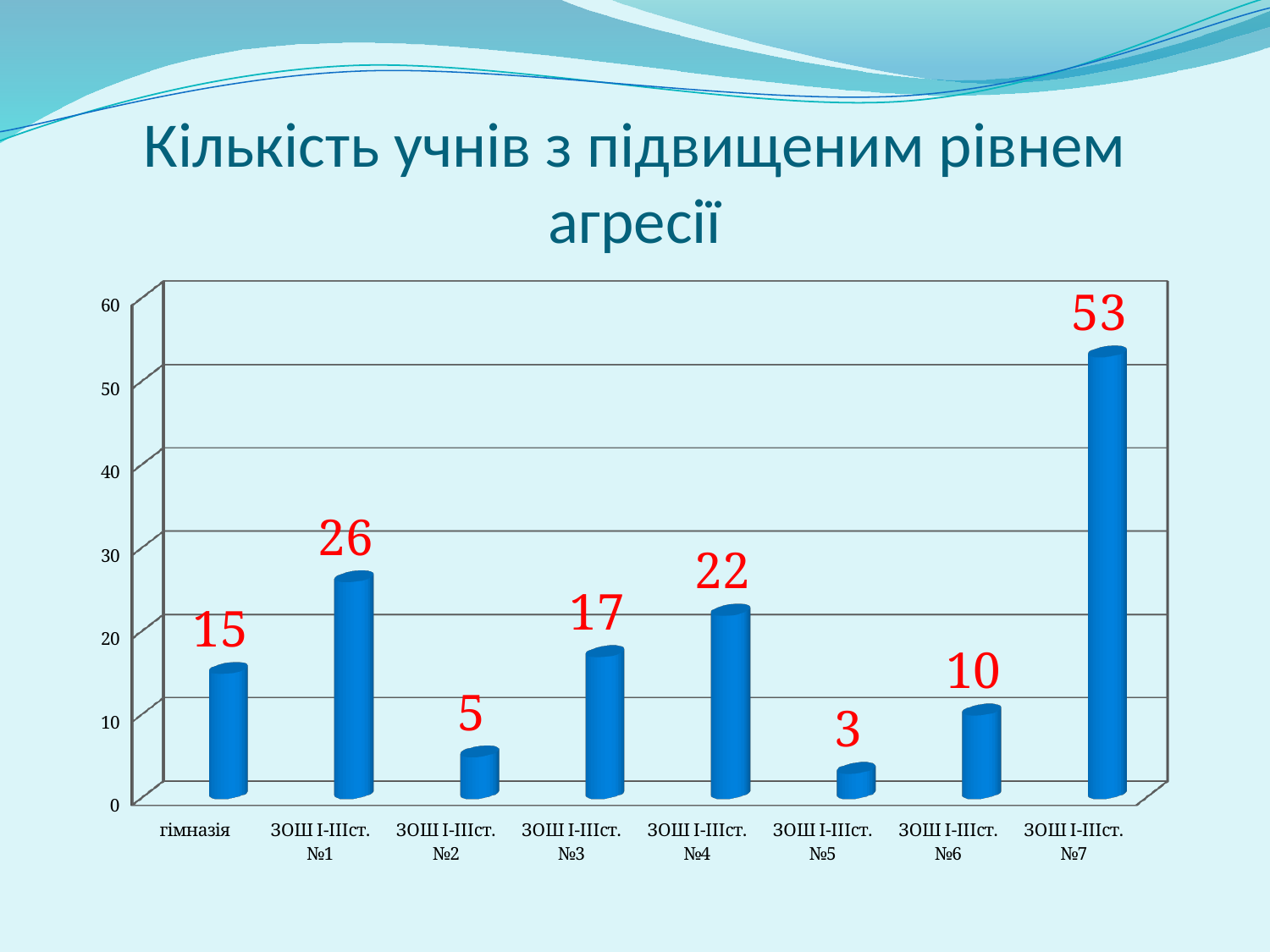
Is the value for ЗОШ І-ІІІст. №7 greater or less than 50? greater What is the title of the chart? Кількість учнів з підвищеним рівнем агресії What is the difference between the values for ЗОШ І-ІІІст. №3 and ЗОШ І-ІІІст. №2? 12 Which category has the lowest value? ЗОШ І-ІІІст. №5 What is the value for ЗОШ І-ІІІст. №4? 22 Which is larger, the value for ЗОШ І-ІІІст. №1 or the value for ЗОШ І-ІІІст. №4? ЗОШ І-ІІІст. №1 What kind of chart is shown on the slide? bar chart How many categories are shown on the x axis? 8 What is the value for гімназія? 15 Which category has the highest value? ЗОШ І-ІІІст. №7 What is the value for ЗОШ І-ІІІст. №6? 10 What is the difference between the values for ЗОШ І-ІІІст. №7 and ЗОШ І-ІІІст. №1? 27